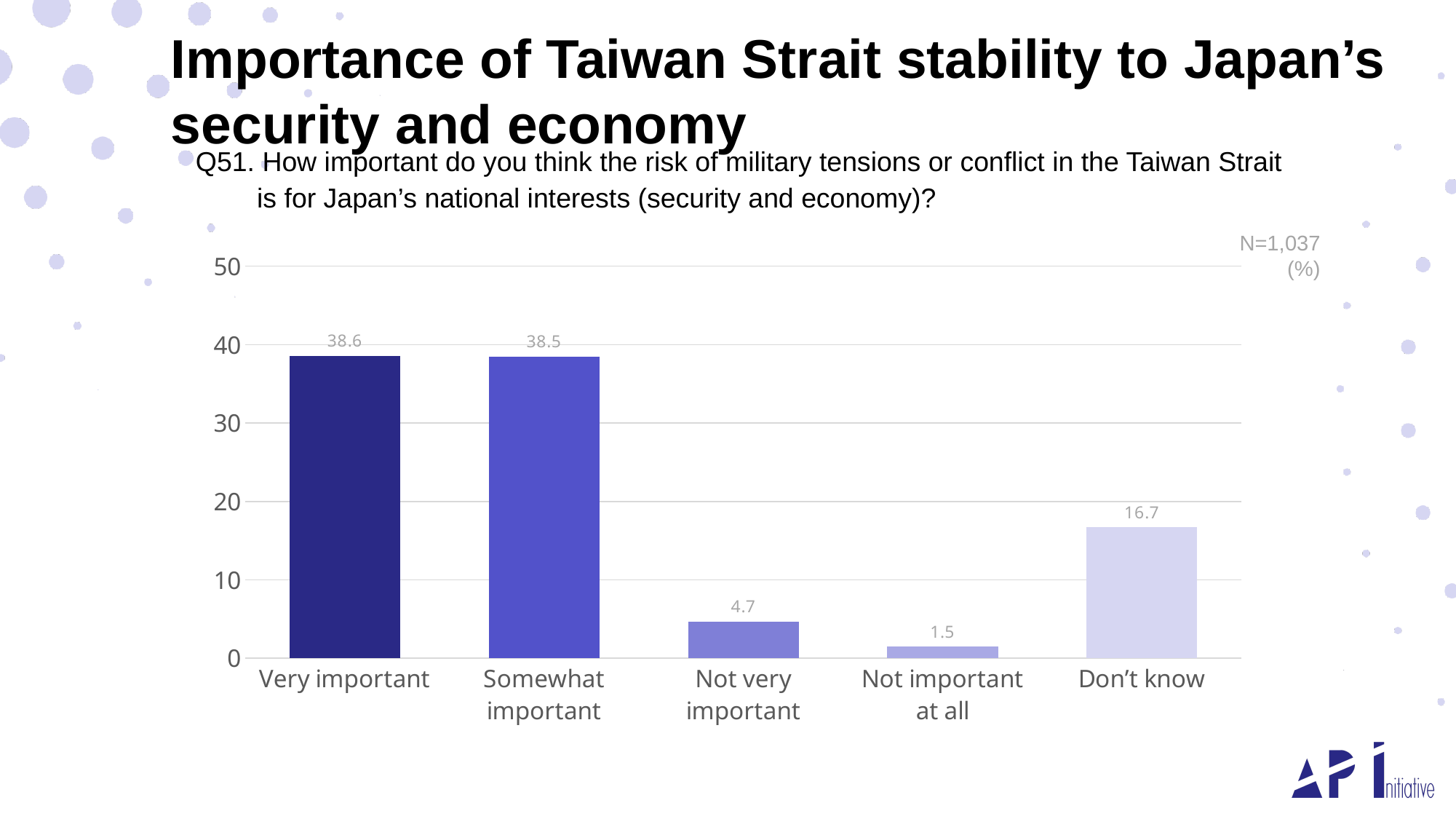
How many categories are shown on the x axis? 5 What is the value for "Somewhat important"? 38.5 Which category has the lowest value? Not important at all What is the value for "Very important"? 38.6 What is the value for "Not very important"? 4.7 What is the value for "Don't know"? 16.7 What sample size (N) is shown on the chart? N=1,037 What is the difference between the values for "Very important" and "Somewhat important"? 0.1 What is the difference between the values for "Don't know" and "Not very important"? 12.0 Is the value for "Don't know" greater or less than 20? less What kind of chart is shown on the slide? bar chart Which is larger, the value for "Don't know" or the value for "Not very important"? Don't know